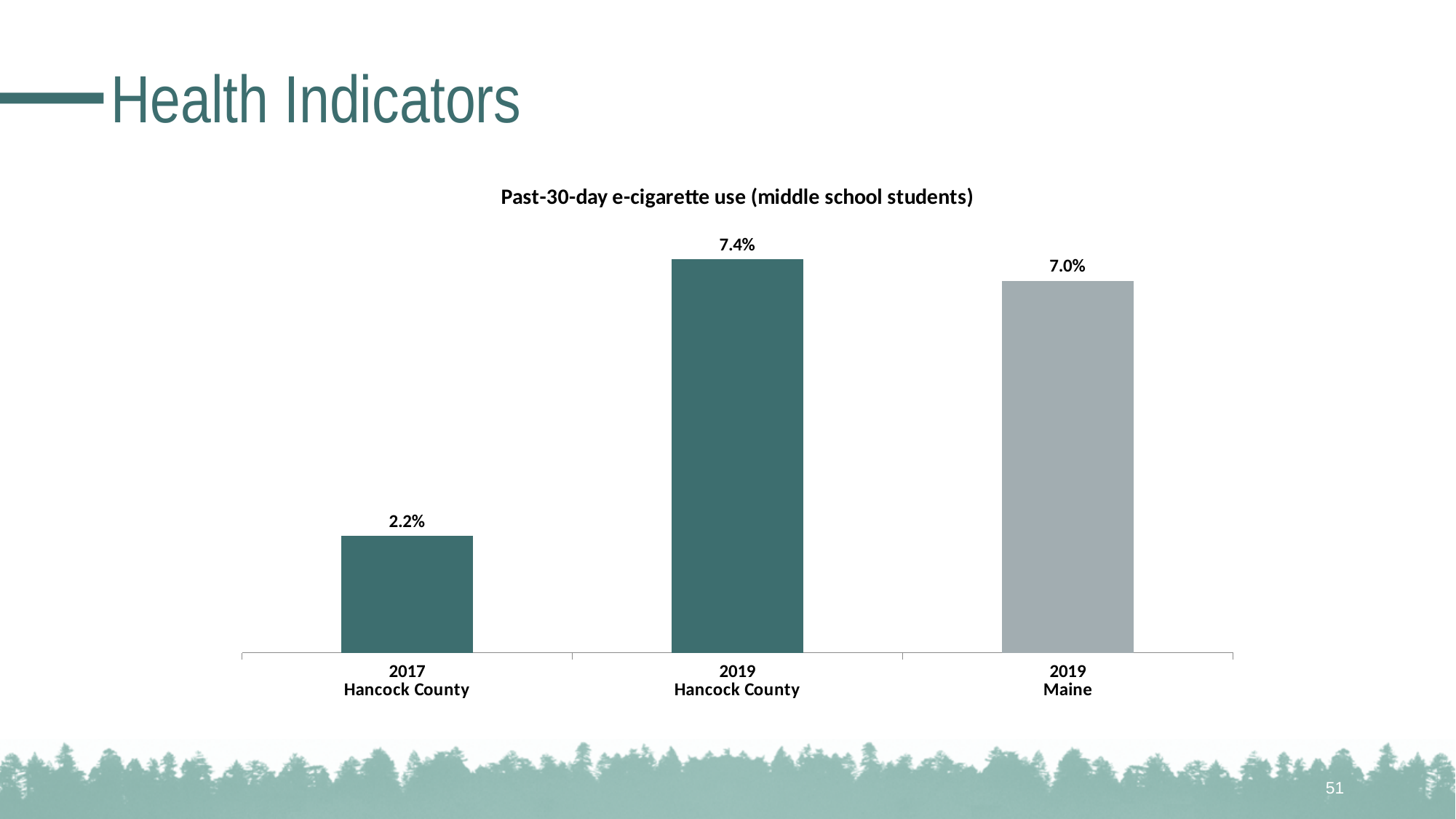
What is the difference between the 2019 Hancock County value and the 2019 Maine value? 0.4% Did the Hancock County value rise or fall from 2017 to 2019? Rise What is the title of the chart? Past-30-day e-cigarette use (middle school students) What is the value for 2019 Maine? 7.0% Which is larger, the value for 2019 Hancock County or the value for 2019 Maine? 2019 Hancock County How many bars are shown in the chart? 3 What is the difference between the 2019 Hancock County value and the 2017 Hancock County value? 5.2% Which category has the highest value? 2019 Hancock County What is the value for 2019 Hancock County? 7.4% What kind of chart is shown on the slide? Bar chart Which category has the lowest value? 2017 Hancock County What is the value for 2017 Hancock County? 2.2%